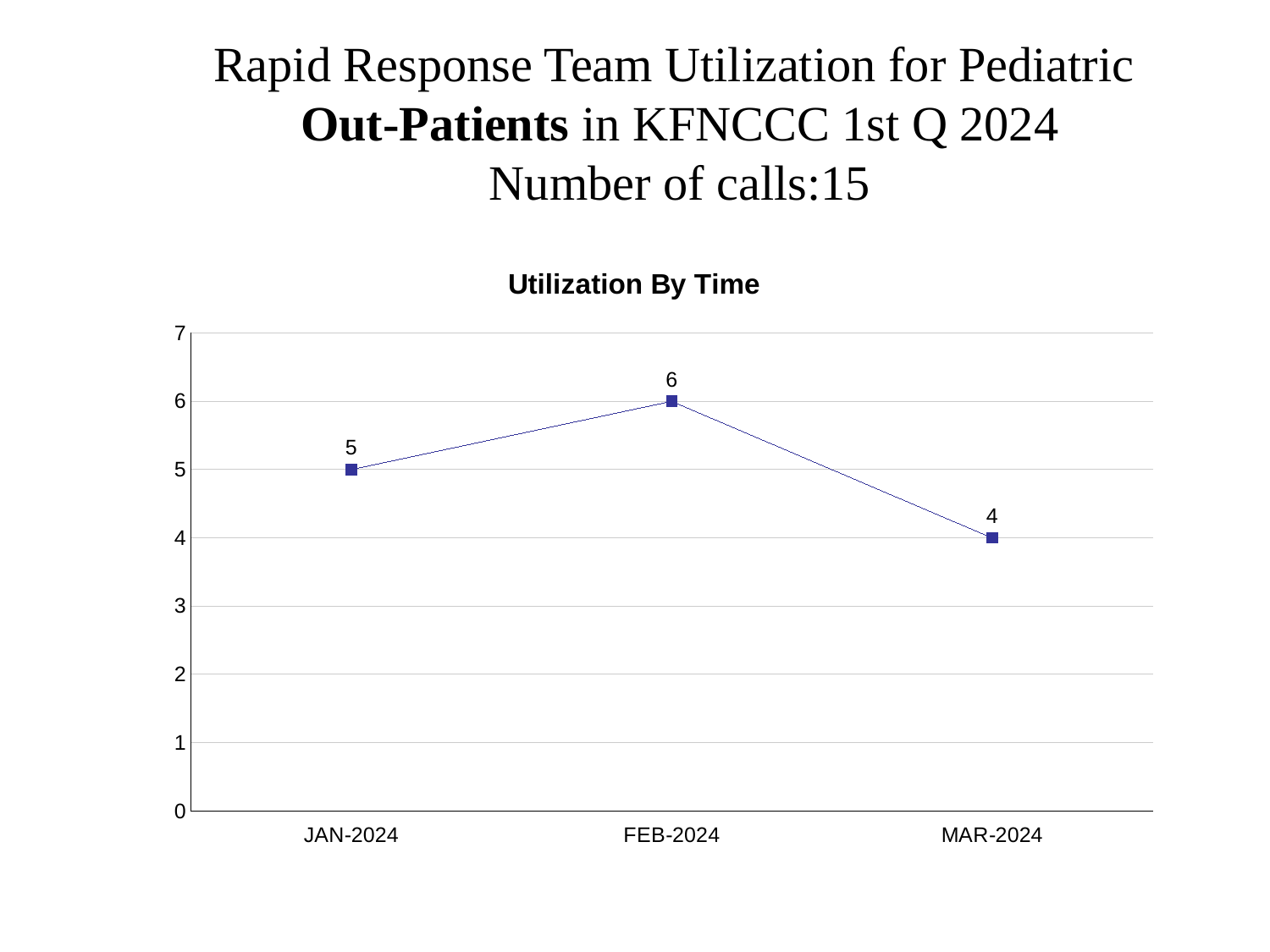
What kind of chart is shown? line chart Which month has the highest value? FEB-2024 Which month has the lowest value? MAR-2024 What is the value for MAR-2024? 4 Does the value rise or fall from FEB-2024 to MAR-2024? fall Which is larger, the value for JAN-2024 or the value for MAR-2024? JAN-2024 Is the value for FEB-2024 greater or less than 5? greater What is the value for JAN-2024? 5 How many months are plotted on the chart? 3 What is the title of the chart? Utilization By Time What is the value for FEB-2024? 6 What is the difference between the values for FEB-2024 and MAR-2024? 2